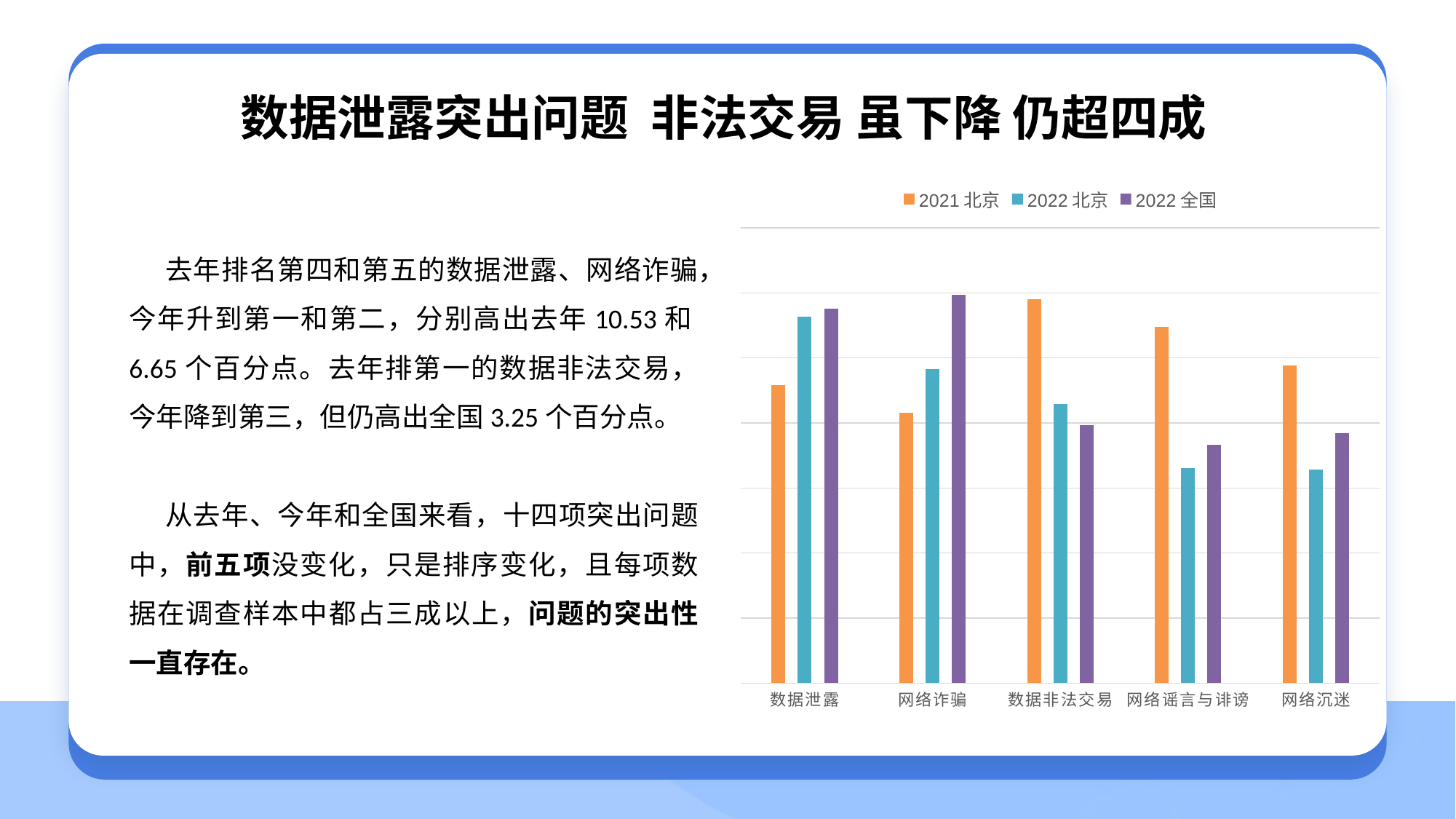
Which category has the highest value for the 2021 北京 series? 数据非法交易 How many series does the chart legend list? 3 What kind of chart is shown on the slide? bar chart Which series is shown in orange in the chart legend? 2021 北京 Which category has the highest value for the 2022 北京 series? 数据泄露 Which series is shown in purple in the chart legend? 2022 全国 Do the 2022 北京 values rise or fall from 数据泄露 to 网络谣言与诽谤 along the x axis? fall Which category has the lowest value for the 2021 北京 series? 网络诈骗 For 网络诈骗, which is larger: the 2021 北京 value or the 2022 全国 value? 2022 全国 For 数据非法交易, which is larger: the 2021 北京 value or the 2022 全国 value? 2021 北京 For 数据泄露, which is larger: the 2021 北京 value or the 2022 北京 value? 2022 北京 How many categories are shown on the x axis of the chart? 5